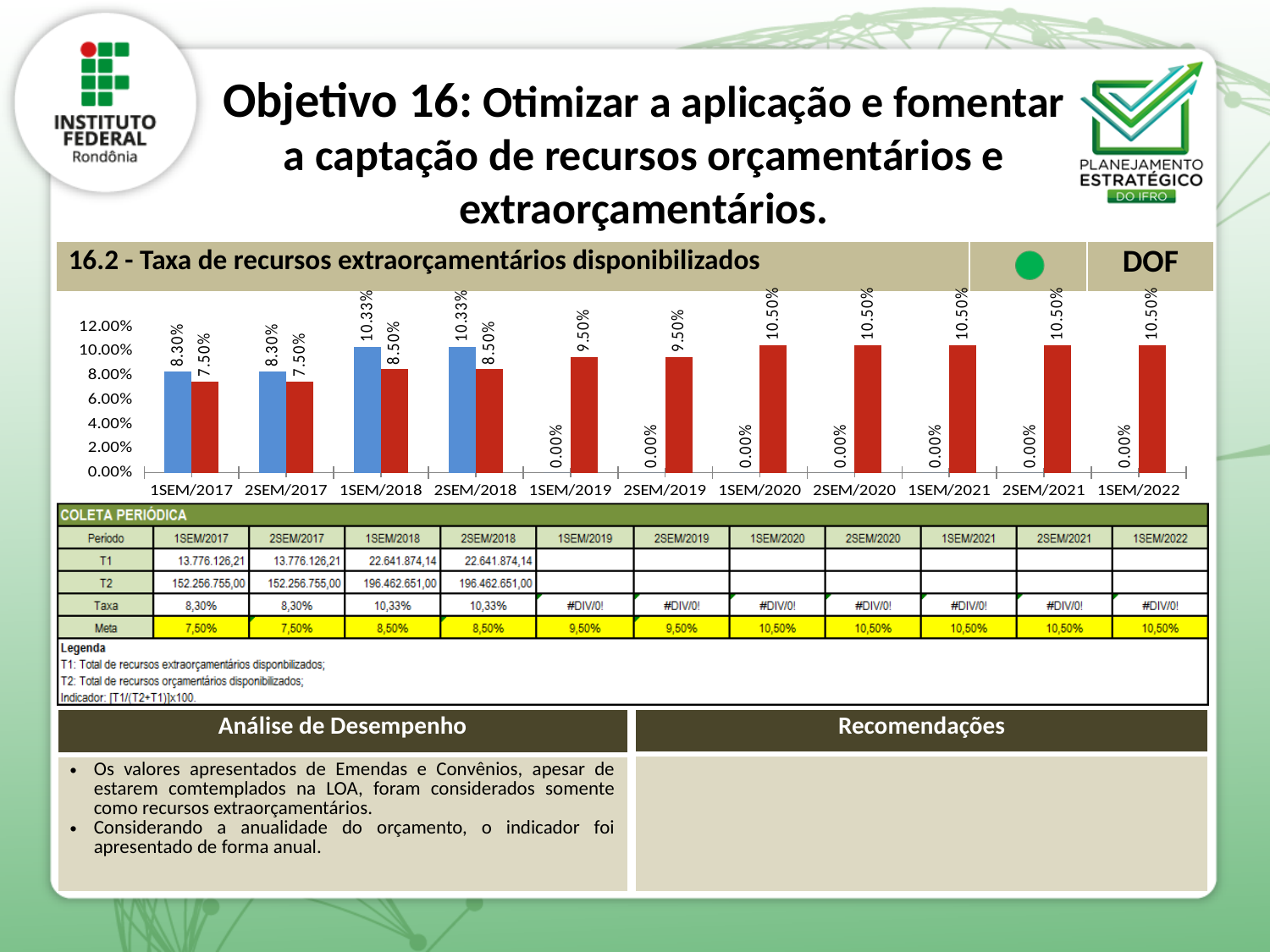
How many periods are shown on the x axis of the chart? 11 What is the title of the indicator shown above the chart? 16.2 - Taxa de recursos extraorçamentários disponibilizados What is the difference between the blue bar and the red bar for 1SEM/2018? 1.83% What is the value of the blue bar for 2SEM/2017? 8.30% What type of chart is shown on the slide? bar chart What is the value of the blue bar for 1SEM/2018? 10.33% What is the value of the blue bar for 2SEM/2020? 0.00% Which is larger for 2SEM/2017, the blue bar or the red bar? the blue bar What is the value of the red bar for 1SEM/2022? 10.50% Which period has the highest red bar value? 1SEM/2020 (tied with 2SEM/2020, 1SEM/2021, 2SEM/2021 and 1SEM/2022 at 10.50%) What is the value of the red bar for 1SEM/2019? 9.50% Do the red bar values rise or fall from 1SEM/2017 to 1SEM/2022? rise